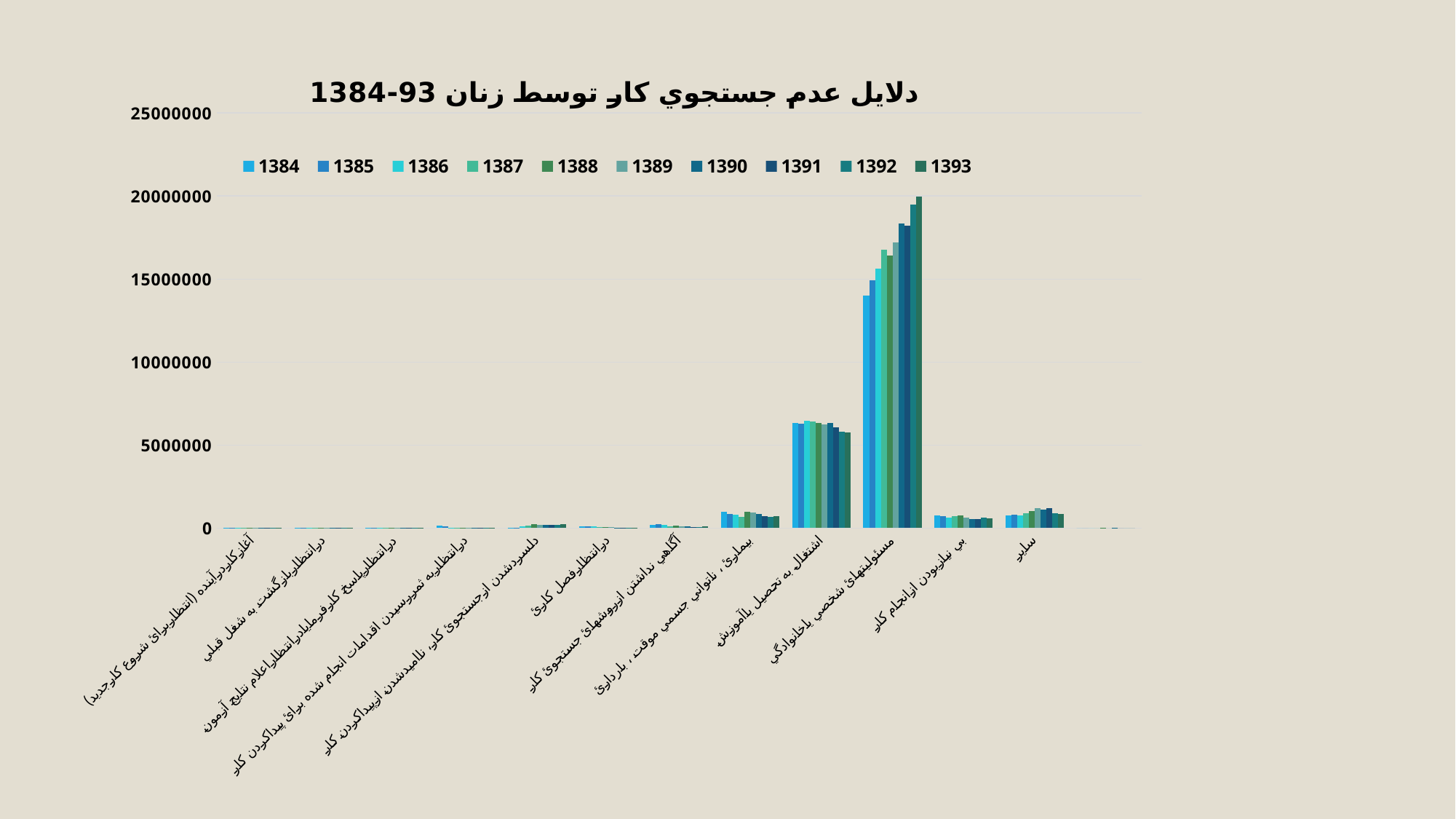
Do the values for the category مسئولیتهاي شخصي یاخانوادگي rise or fall from 1384 to 1393? rise Is the value for 1384 in the category مسئولیتهاي شخصي یاخانوادگي greater or less than 15000000? less Within the category مسئولیتهاي شخصي یاخانوادگي, which year has the shortest bar? 1384 What is the title of the chart? دلایل عدم جستجوي کار توسط زنان 1384-93 Which category has the highest bars in the chart? مسئولیتهاي شخصي یاخانوادگي Within the category مسئولیتهاي شخصي یاخانوادگي, which year has the tallest bar? 1393 Is the value for 1393 in the category مسئولیتهاي شخصي یاخانوادگي greater or less than 15000000? greater Which category has larger values, اشتغال به تحصیل یاآموزش or مسئولیتهاي شخصي یاخانوادگي? مسئولیتهاي شخصي یاخانوادگي What kind of chart is shown on the slide? bar chart Is the value for 1386 in the category اشتغال به تحصیل یاآموزش greater or less than 5000000? greater Which year is the first entry in the legend? 1384 How many series does the legend list? 10